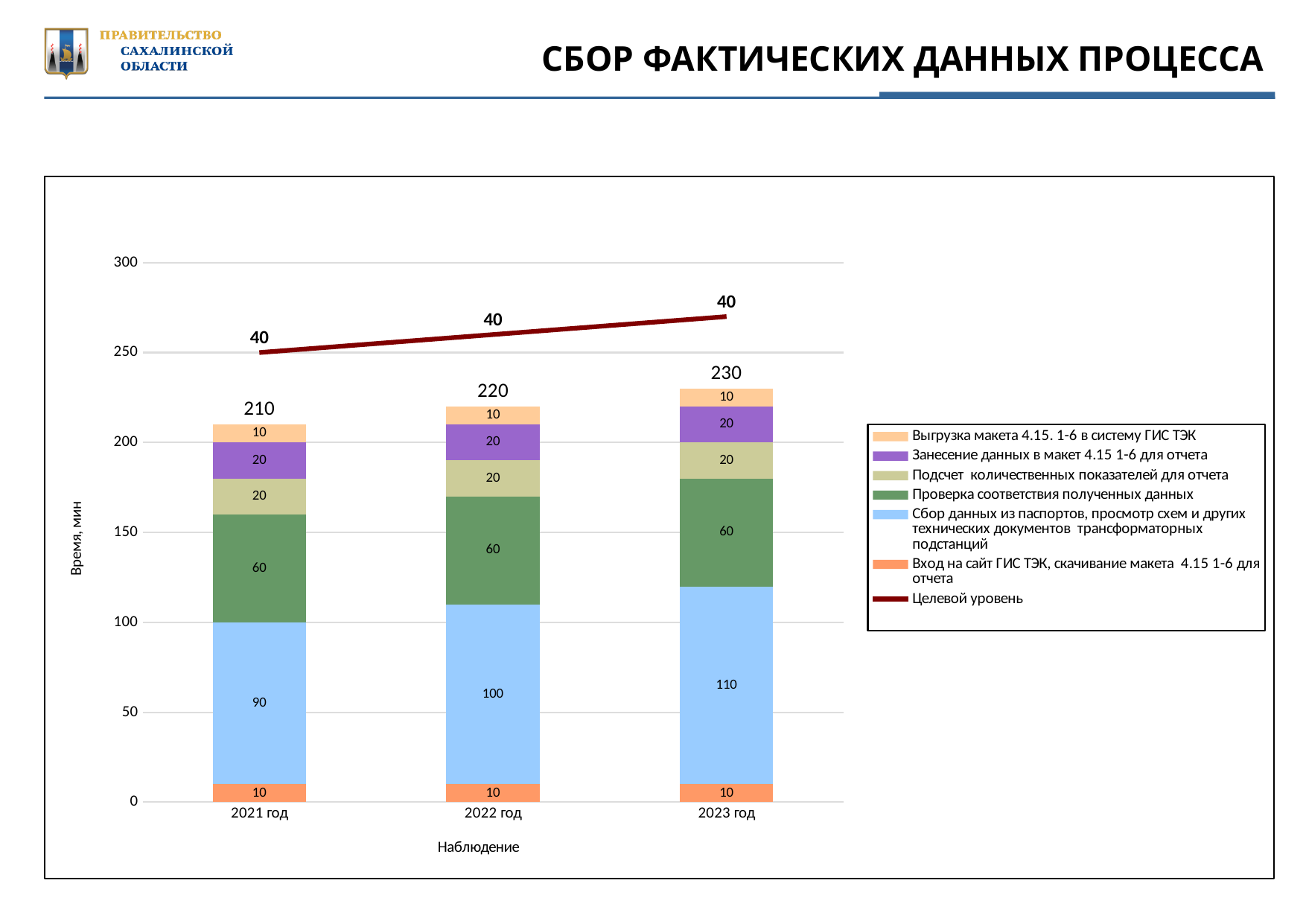
What is the value of the 'Сбор данных из паспортов, просмотр схем и других технических документов трансформаторных подстанций' segment for 2023 год? 110 What kind of chart is shown on the slide? Stacked bar chart with a line What value is labelled on the 'Целевой уровень' line for 2022 год? 40 Which is larger: the 'Сбор данных из паспортов...' segment for 2021 год or for 2023 год? 2023 год What is the value of the 'Проверка соответствия полученных данных' segment for 2022 год? 60 What is the title of the vertical axis? Время, мин Which year has the highest total bar value? 2023 год How many categories are shown on the x axis? 3 What is the total value shown above the stacked bar for 2021 год? 210 Do the total bar values rise or fall from 2021 год to 2023 год? Rise What is the difference between the total for 2023 год and the total for 2021 год? 20 How many series does the legend list? 7